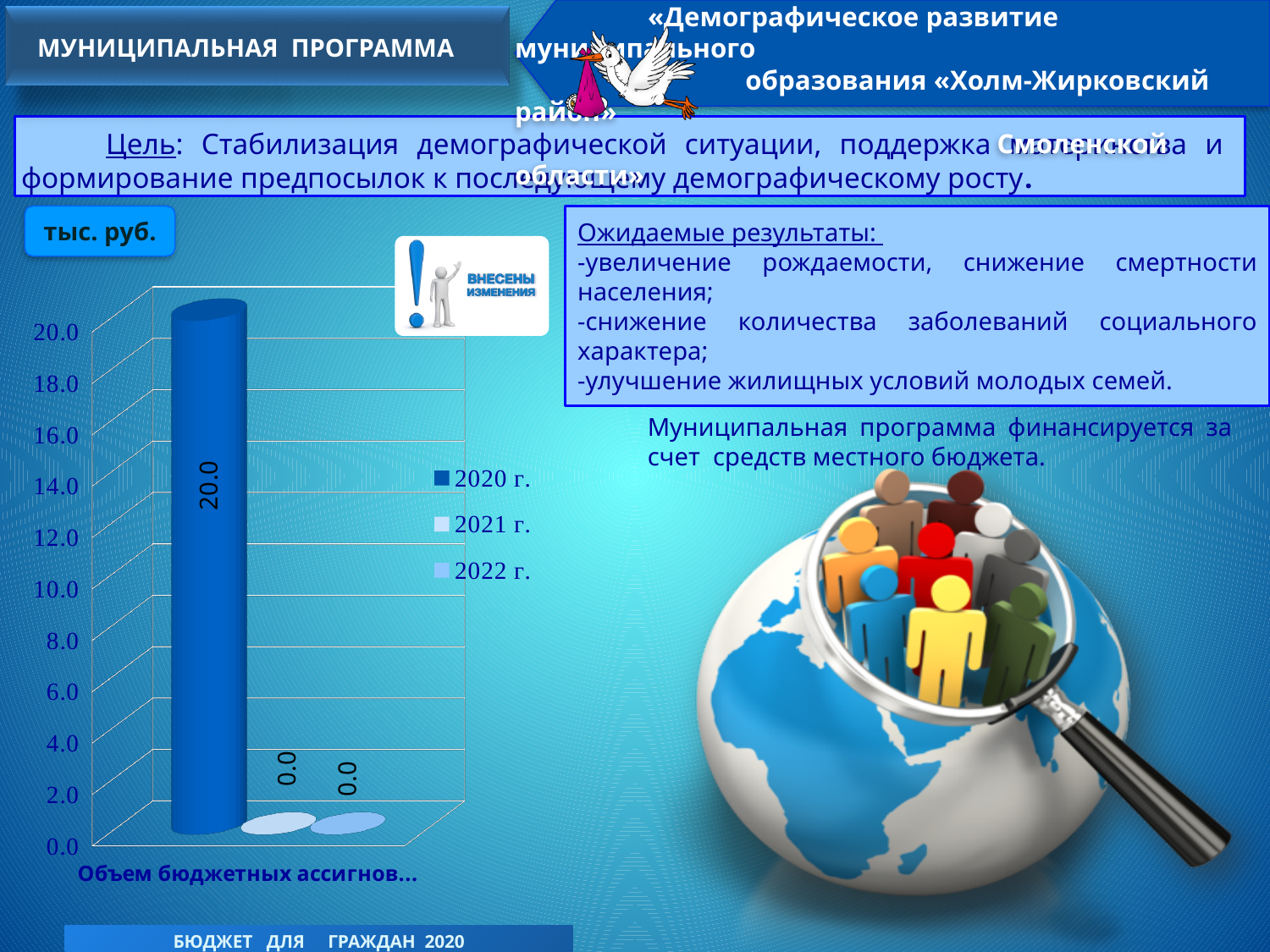
What unit is indicated for the chart values on the slide? тыс. руб. What is the value for the 2020 г. series in the chart? 20.0 Do the values fall or rise from the 2020 г. series to the 2022 г. series? fall Which is larger, the value for 2020 г. or the value for 2022 г.? 2020 г. What is the value for the 2021 г. series in the chart? 0.0 Which series has the highest value in the chart? 2020 г. What kind of chart is shown on the slide? bar chart What is the difference between the values for 2020 г. and 2021 г.? 20.0 How many series does the chart legend list? 3 What is the value for the 2022 г. series in the chart? 0.0 What is the highest tick value shown on the vertical axis of the chart? 20.0 Is the value for 2020 г. greater or less than 10.0? greater